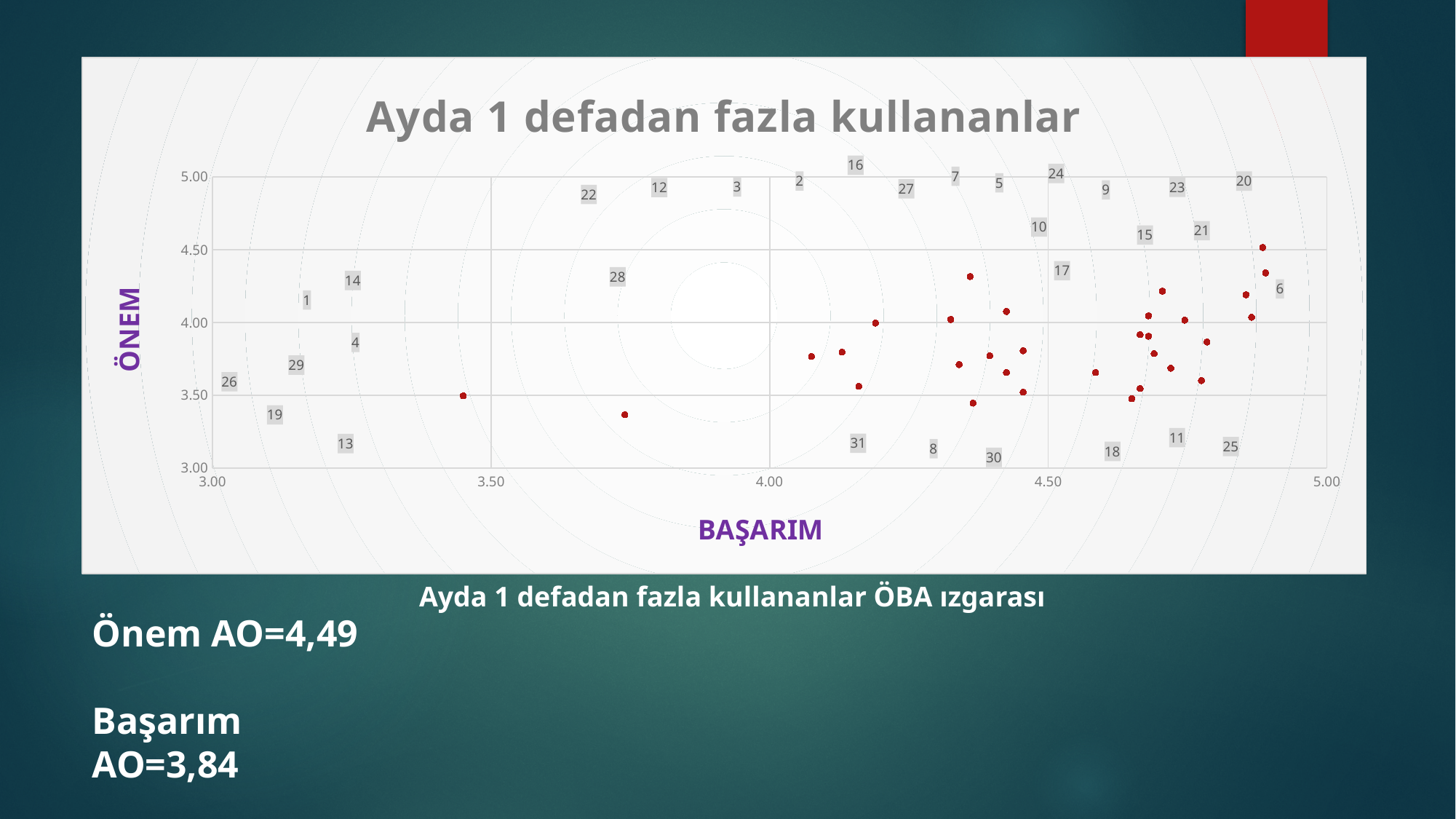
What is the title of the chart? Ayda 1 defadan fazla kullananlar What is the label of the horizontal axis of the chart? BAŞARIM How many numbered point labels are shown on the chart? 31 What kind of chart is shown on the slide? scatter chart Are most of the plotted points to the right or to the left of 4.00 on the BAŞARIM axis? right Is the ÖNEM value of the lowest plotted point greater or less than 3.50? less